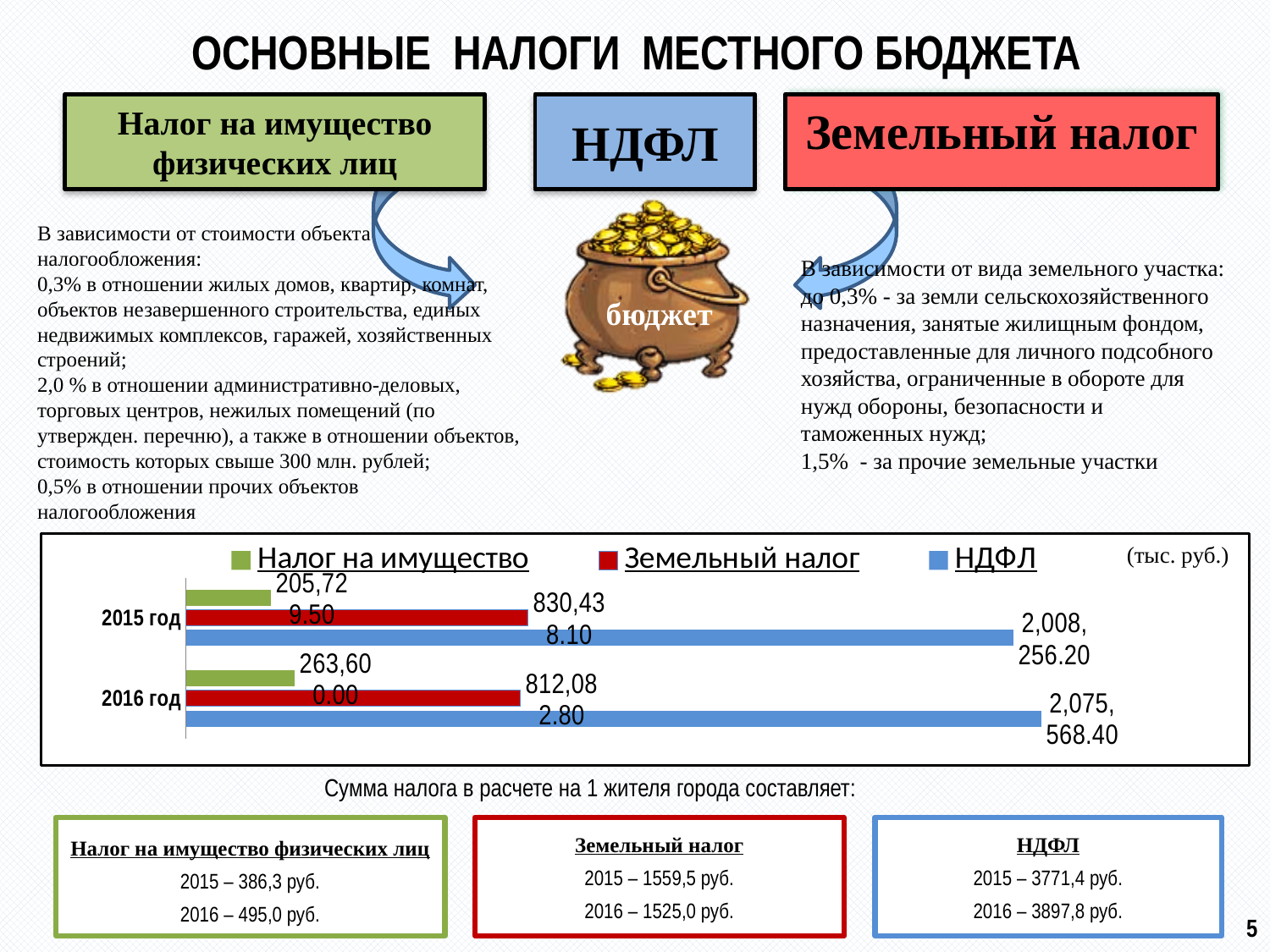
What is the value of Земельный налог for 2016 год on the chart? 812,082.80 What kind of chart is shown on the slide? bar chart Which series has the lowest value for 2015 год? Налог на имущество How many series does the chart legend list? 3 What is the value of Налог на имущество for 2016 год on the chart? 263,600.00 What is the difference between the НДФЛ values for 2016 год and 2015 год? 67,312.20 What is the value of НДФЛ for 2015 год on the chart? 2,008,256.20 How many year categories are shown on the chart? 2 In what units are the chart values given, according to the note next to the legend? тыс. руб. Does the value of Налог на имущество rise or fall from 2015 год to 2016 год? rise Which is larger: Земельный налог in 2015 год or Земельный налог in 2016 год? 2015 год Which series has the highest value for 2016 год? НДФЛ